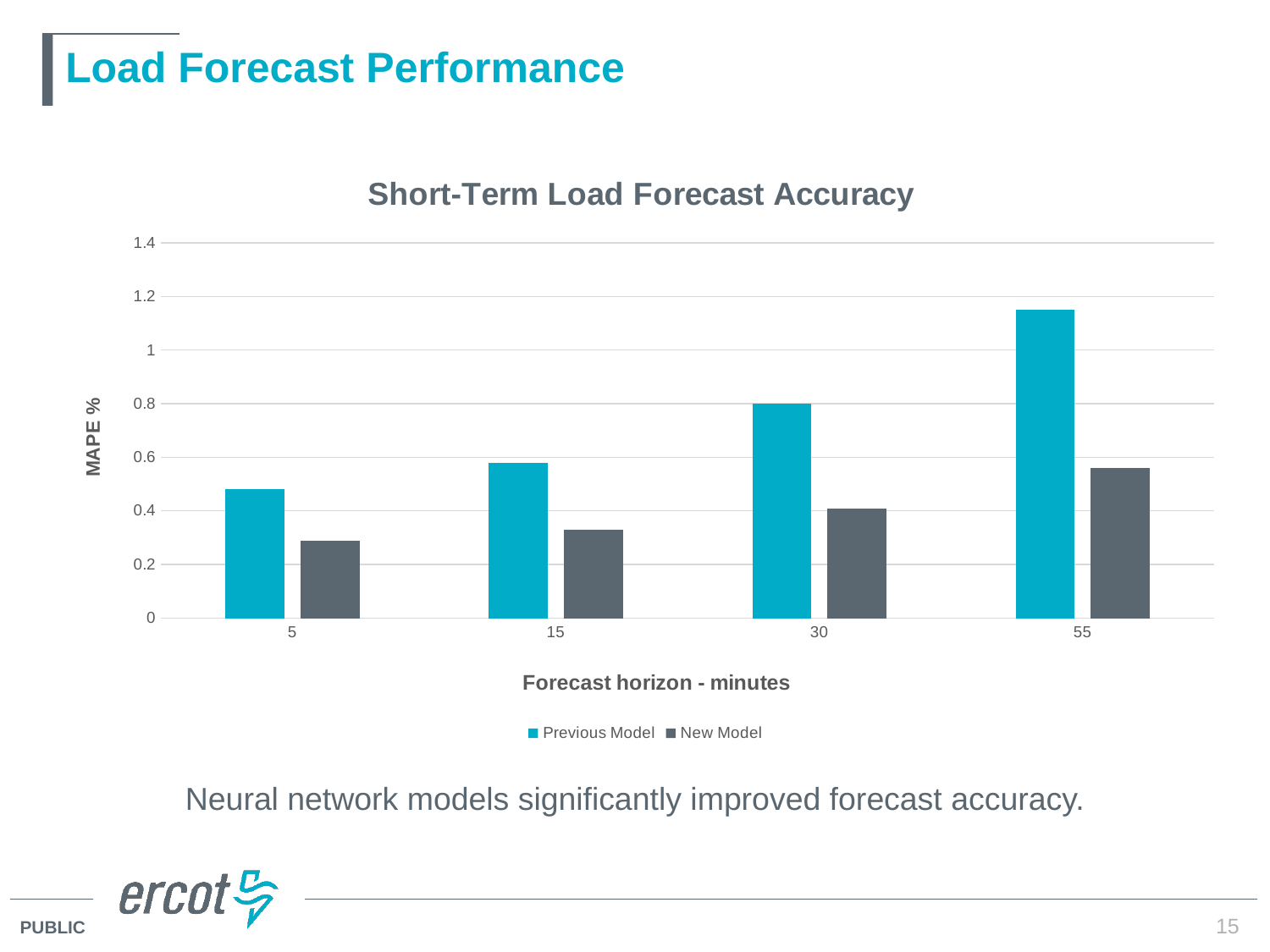
How many series does the legend list? 2 What is the label on the y axis of the chart? MAPE % At the 55-minute horizon, which series has the larger MAPE, Previous Model or New Model? Previous Model At which forecast horizon is the New Model MAPE lowest? 5 Is the New Model value at the 5-minute horizon greater or less than 0.4? less Do the Previous Model values rise or fall as the forecast horizon increases? rise Is the New Model value at the 30-minute horizon greater or less than 0.6? less What is the title of the chart? Short-Term Load Forecast Accuracy At which forecast horizon is the Previous Model MAPE highest? 55 What kind of chart is shown on the slide? bar chart How many forecast horizon categories are shown on the x axis? 4 Is the Previous Model value at the 55-minute horizon greater or less than 1? greater